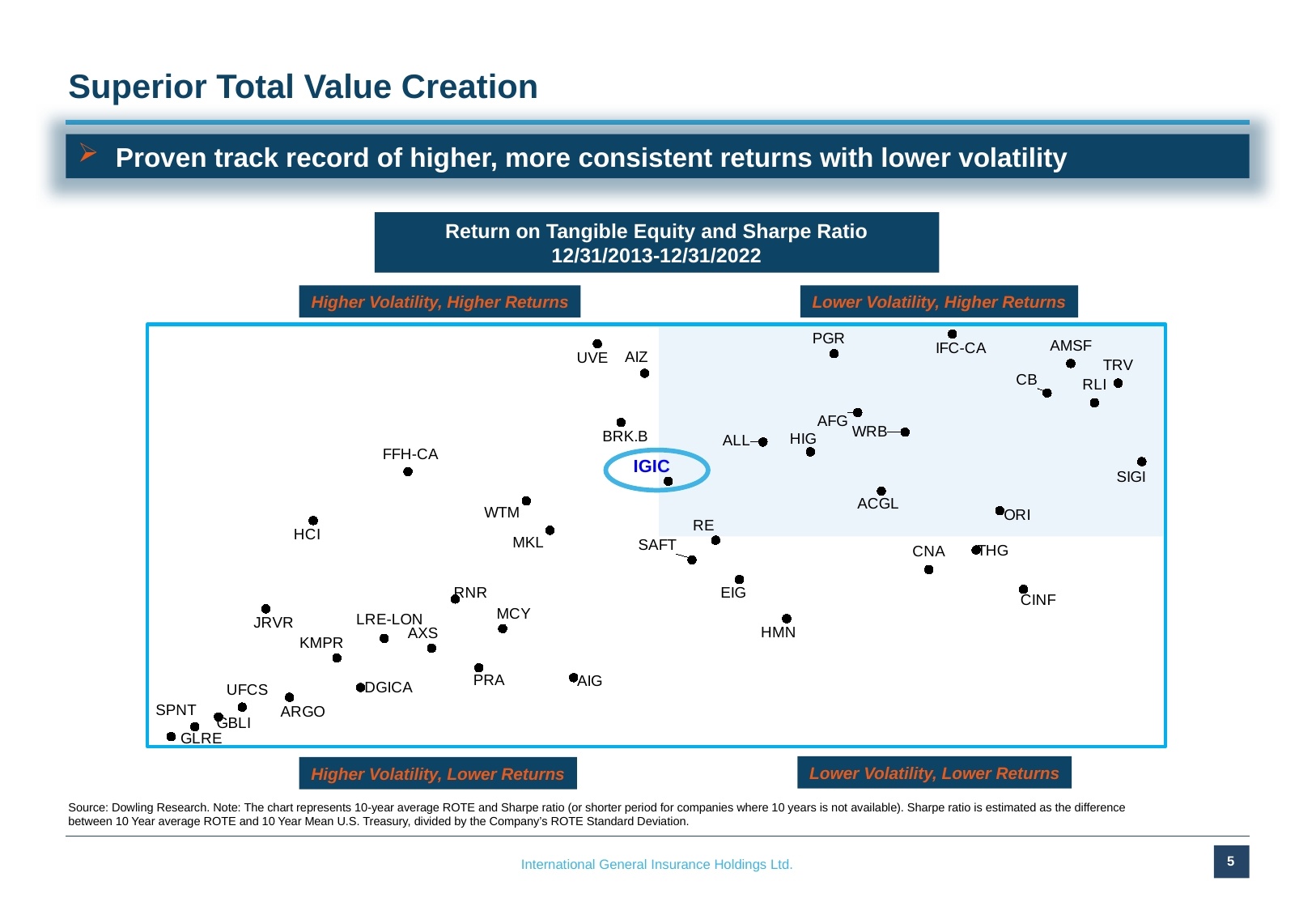
Which company is plotted furthest to the right on the chart? SIGI What is the title of the chart? Return on Tangible Equity and Sharpe Ratio 12/31/2013-12/31/2022 Which company is circled and highlighted in blue on the chart? IGIC Which is plotted further to the right on the chart, TRV or AMSF? TRV Which is plotted higher on the chart, CNA or CINF? CNA Which is plotted higher on the chart, EIG or HMN? EIG Which company is plotted lowest on the chart? GLRE What kind of chart is shown on the slide? Scatter chart